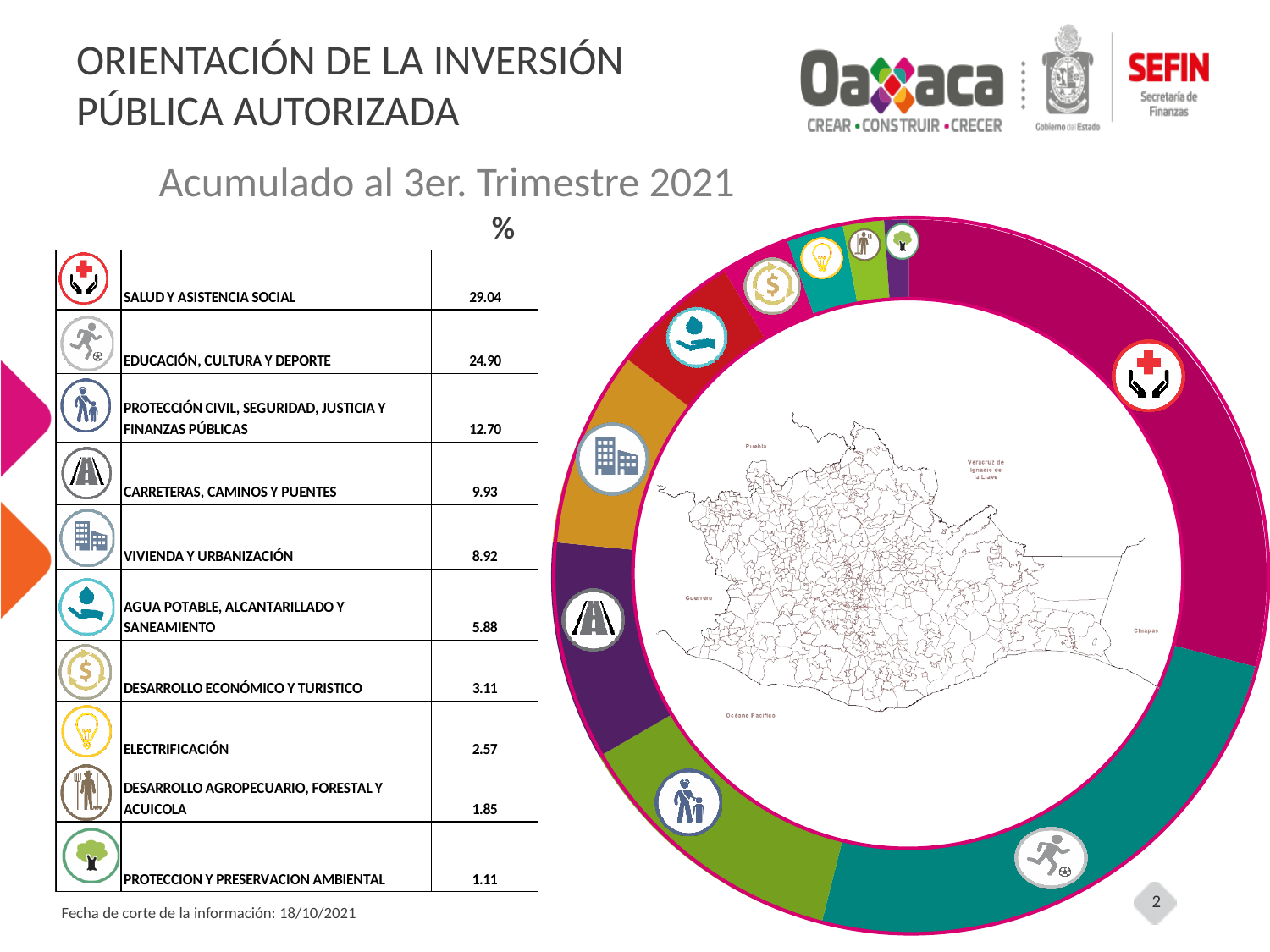
What is the difference in percentage points between DESARROLLO ECONÓMICO Y TURISTICO and DESARROLLO AGROPECUARIO, FORESTAL Y ACUICOLA? 1.26 What percentage is shown for CARRETERAS, CAMINOS Y PUENTES? 9.93 What is the subtitle shown above the chart and table? Acumulado al 3er. Trimestre 2021 Which category has the smallest share of the authorized public investment? PROTECCION Y PRESERVACION AMBIENTAL What is the difference in percentage points between SALUD Y ASISTENCIA SOCIAL and EDUCACIÓN, CULTURA Y DEPORTE? 4.14 What kind of chart is shown on the right of the slide? doughnut chart What percentage is shown for ELECTRIFICACIÓN? 2.57 Which is larger, the share for VIVIENDA Y URBANIZACIÓN or the share for AGUA POTABLE, ALCANTARILLADO Y SANEAMIENTO? VIVIENDA Y URBANIZACIÓN How many categories are listed in the table next to the doughnut chart? 10 What percentage is shown for SALUD Y ASISTENCIA SOCIAL? 29.04 What percentage is shown for EDUCACIÓN, CULTURA Y DEPORTE? 24.90 Which category has the largest share of the authorized public investment? SALUD Y ASISTENCIA SOCIAL